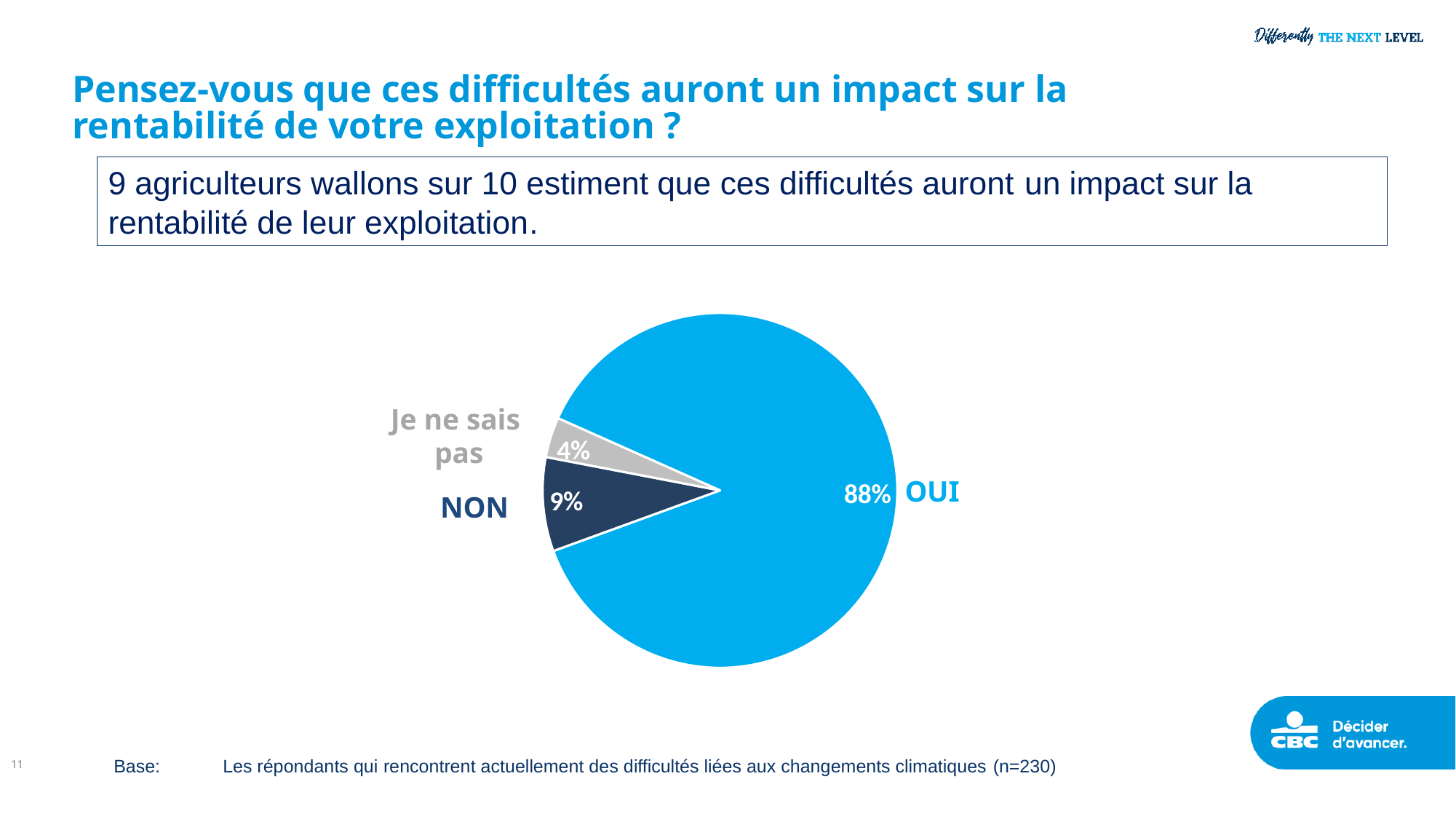
What kind of chart is shown on the slide? pie chart Which response has the smallest share of the pie? Je ne sais pas Which is larger, the share for NON or the share for Je ne sais pas? NON What percentage of respondents answered OUI? 88% Which response has the largest share of the pie? OUI What percentage of respondents answered NON? 9% How many slices does the pie chart have? 3 What is the base size (n) stated for the chart? n=230 What percentage of respondents answered Je ne sais pas? 4% What is the difference in percentage points between NON and Je ne sais pas? 5 What colour is the OUI slice of the pie? light blue What is the difference in percentage points between OUI and NON? 79